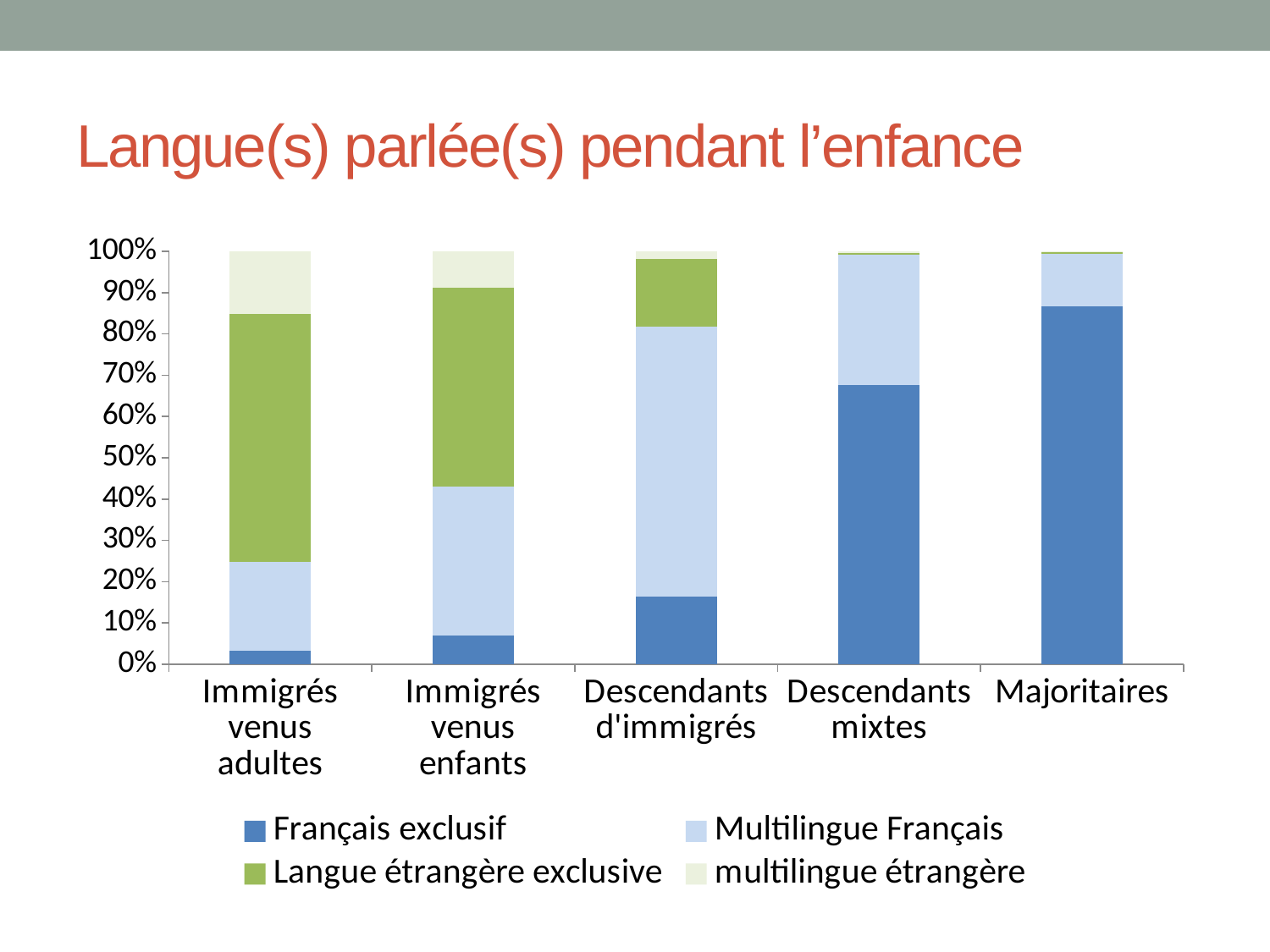
Which category has the lowest share of Français exclusif? Immigrés venus adultes Which category has the highest share of Français exclusif? Majoritaires Which series is shown in dark blue in the legend? Français exclusif What is the title of the slide? Langue(s) parlée(s) pendant l'enfance How many series does the legend list? 4 What kind of chart is shown on the slide? Stacked bar chart Does the Français exclusif share rise or fall from left to right across the categories? rise Is the Français exclusif share for Majoritaires greater or less than 80%? greater Which category has the largest Langue étrangère exclusive segment? Immigrés venus adultes How many categories are shown on the x axis? 5 Is the Français exclusif share for Immigrés venus adultes greater or less than 10%? less Which has a larger Français exclusif share, Descendants mixtes or Descendants d'immigrés? Descendants mixtes